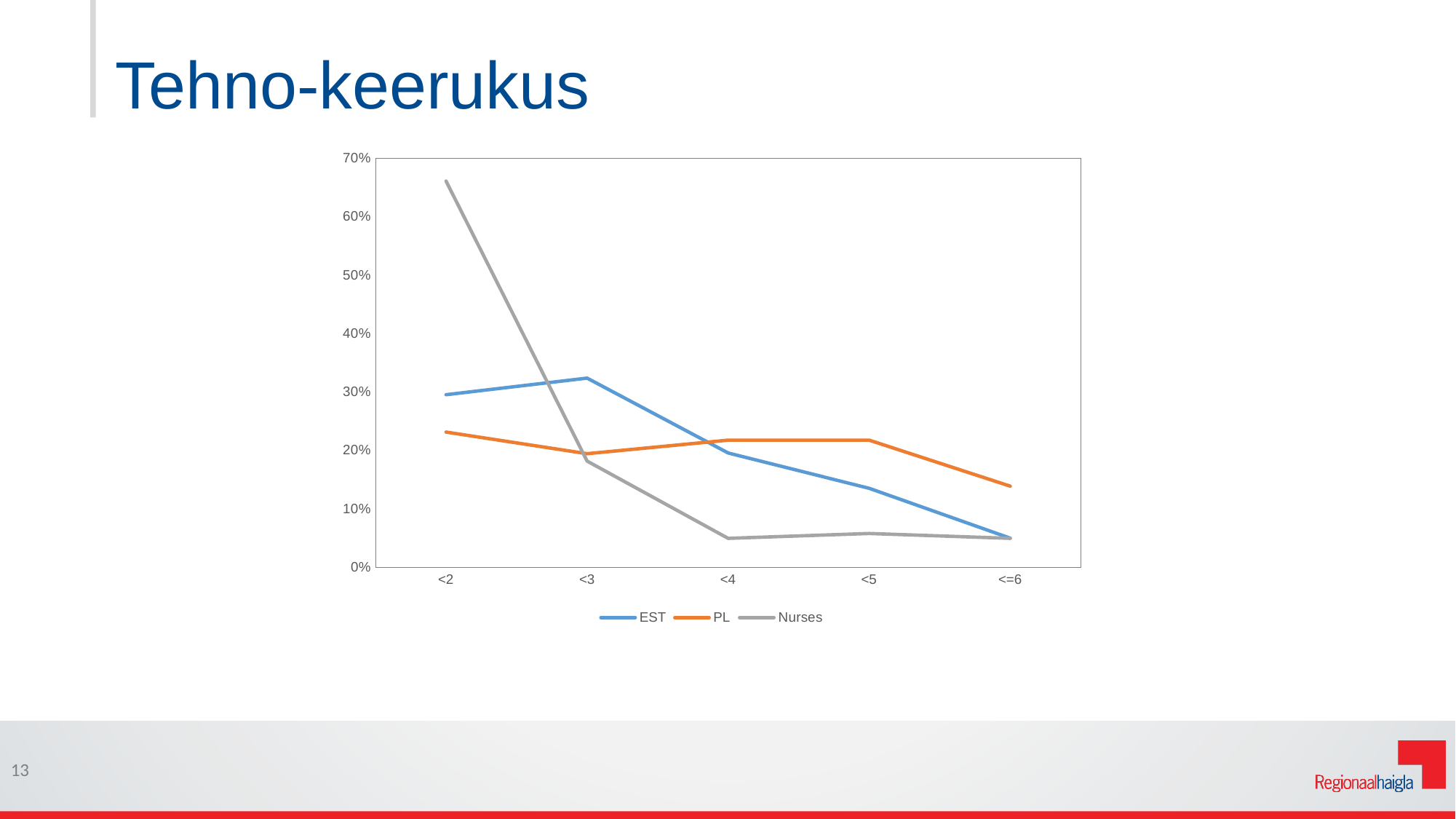
Is the PL value at <=6 greater or less than 10%? greater Is the Nurses value at <4 greater or less than 10%? less How many series does the legend list? 3 At which category does the Nurses series reach its highest value? <2 Which series has the highest value at the <=6 category? PL How many categories are shown on the x axis? 5 Which series has the highest value at the <2 category? Nurses Does the Nurses series rise or fall from <2 to <=6? fall At the <5 category, which is larger, the PL value or the EST value? PL Is the Nurses value at <2 greater or less than 60%? greater What kind of chart is shown on the slide? line chart Which series has the lowest value at the <5 category? Nurses